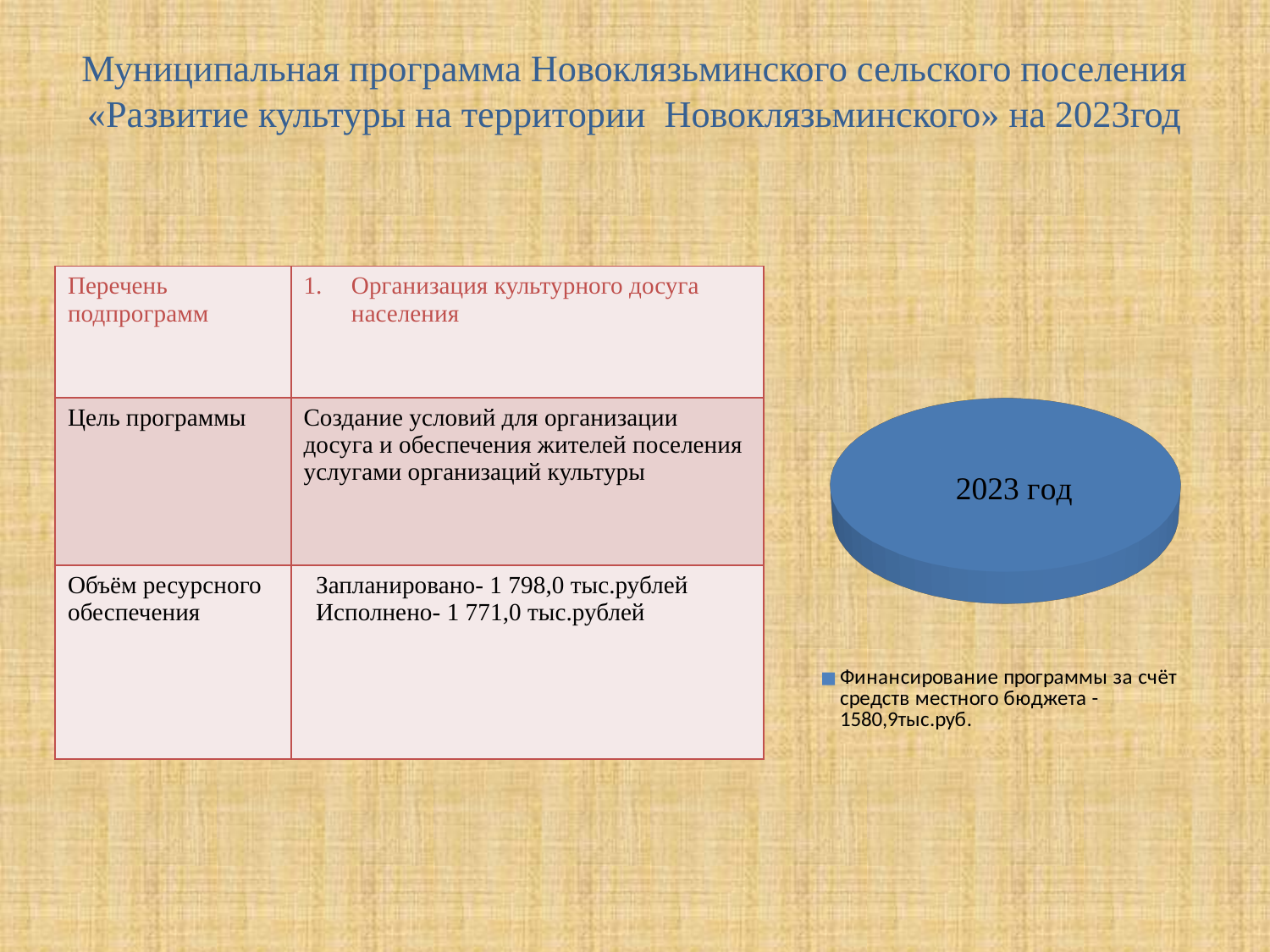
According to the legend, what amount of programme financing from the local budget is shown in the pie chart? 1580,9тыс.руб. What colour is the slice of the pie chart? blue What kind of chart is shown on the slide? pie chart What share of the pie does the single slice take up? 100% What label is printed on the pie chart slice? 2023 год How many entries does the legend of the pie chart list? 1 How many slices does the pie chart have? 1